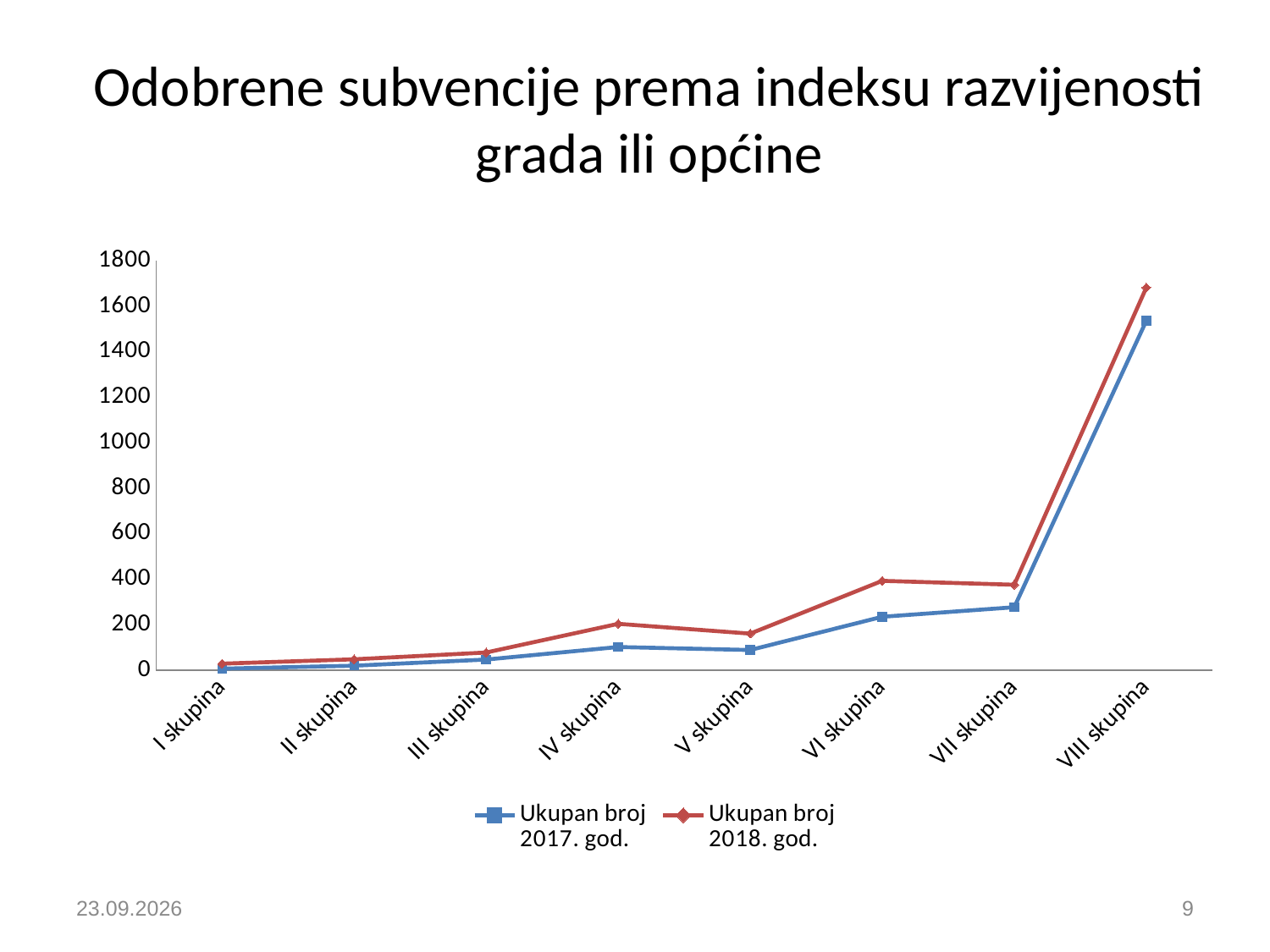
For VIII skupina, which series has the larger value: Ukupan broj 2017. god. or Ukupan broj 2018. god.? Ukupan broj 2018. god. What is the title of the chart slide? Odobrene subvencije prema indeksu razvijenosti grada ili općine What kind of chart is shown on the slide? line chart Which category has the highest value for Ukupan broj 2018. god.? VIII skupina Is the value for VIII skupina in the Ukupan broj 2018. god. series greater or less than 1600? greater Is the value for VIII skupina in the Ukupan broj 2017. god. series greater or less than 1600? less Is the value for IV skupina in the Ukupan broj 2017. god. series greater or less than 200? less In the Ukupan broj 2018. god. series, which is larger: IV skupina or VI skupina? VI skupina Which category has the lowest value for Ukupan broj 2017. god.? I skupina How many series does the legend list? 2 How many categories (skupina) are shown on the x axis? 8